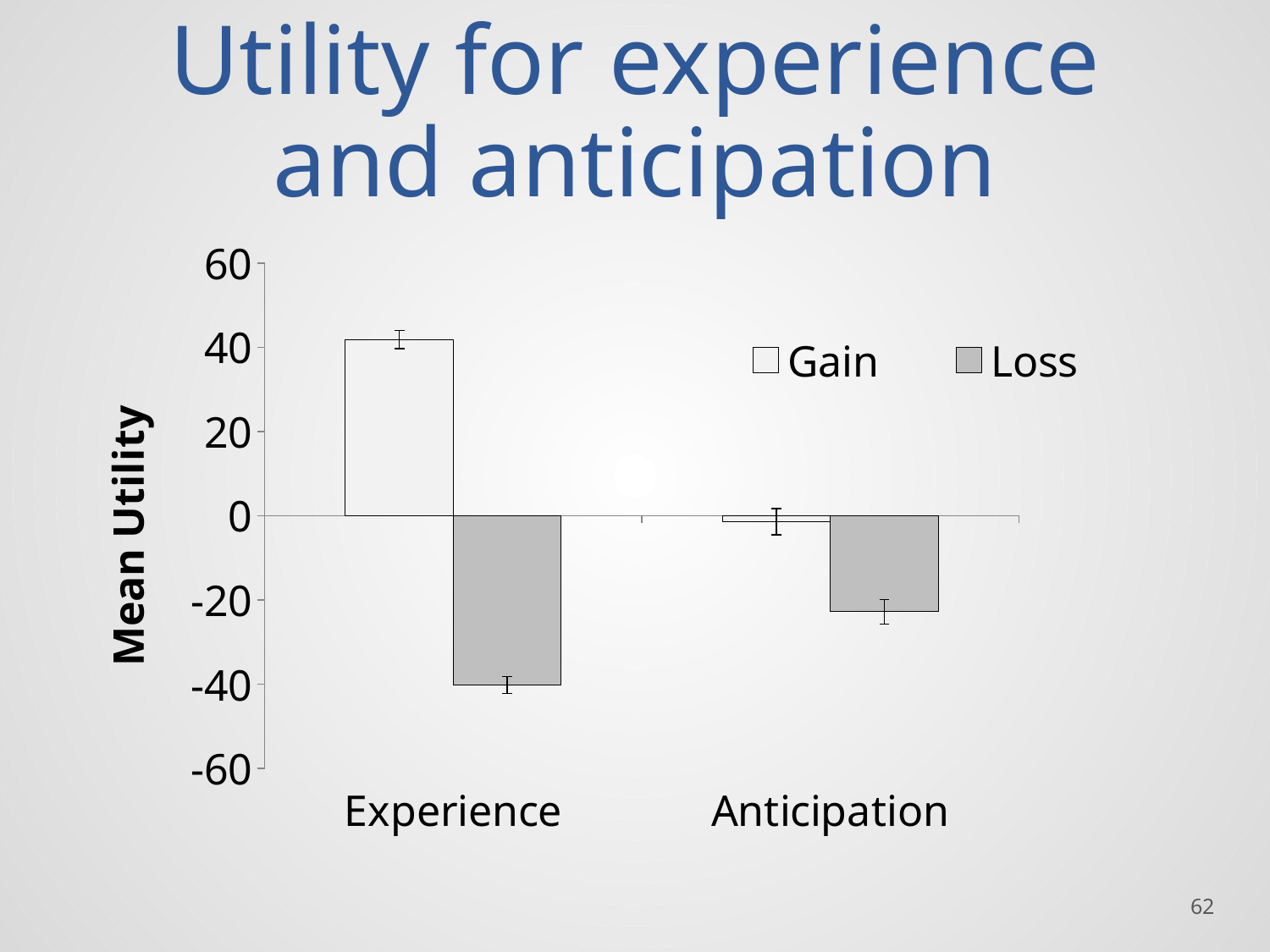
Which bar in the chart has the highest value? Gain for Experience What kind of chart is shown on the slide? bar chart What is the label of the vertical axis of the chart? Mean Utility What are the two series named in the chart's legend? Gain and Loss Which bar in the chart has the lowest value? Loss for Experience How many categories are shown on the x axis of the chart? 2 How many series does the chart's legend list? 2 Is the Gain value for Experience greater or less than 20? greater Which category has the larger Gain value, Experience or Anticipation? Experience Is the Loss value for Experience greater or less than -20? less Which category has the lower Loss value, Experience or Anticipation? Experience Is the Loss value for Anticipation greater or less than -40? greater